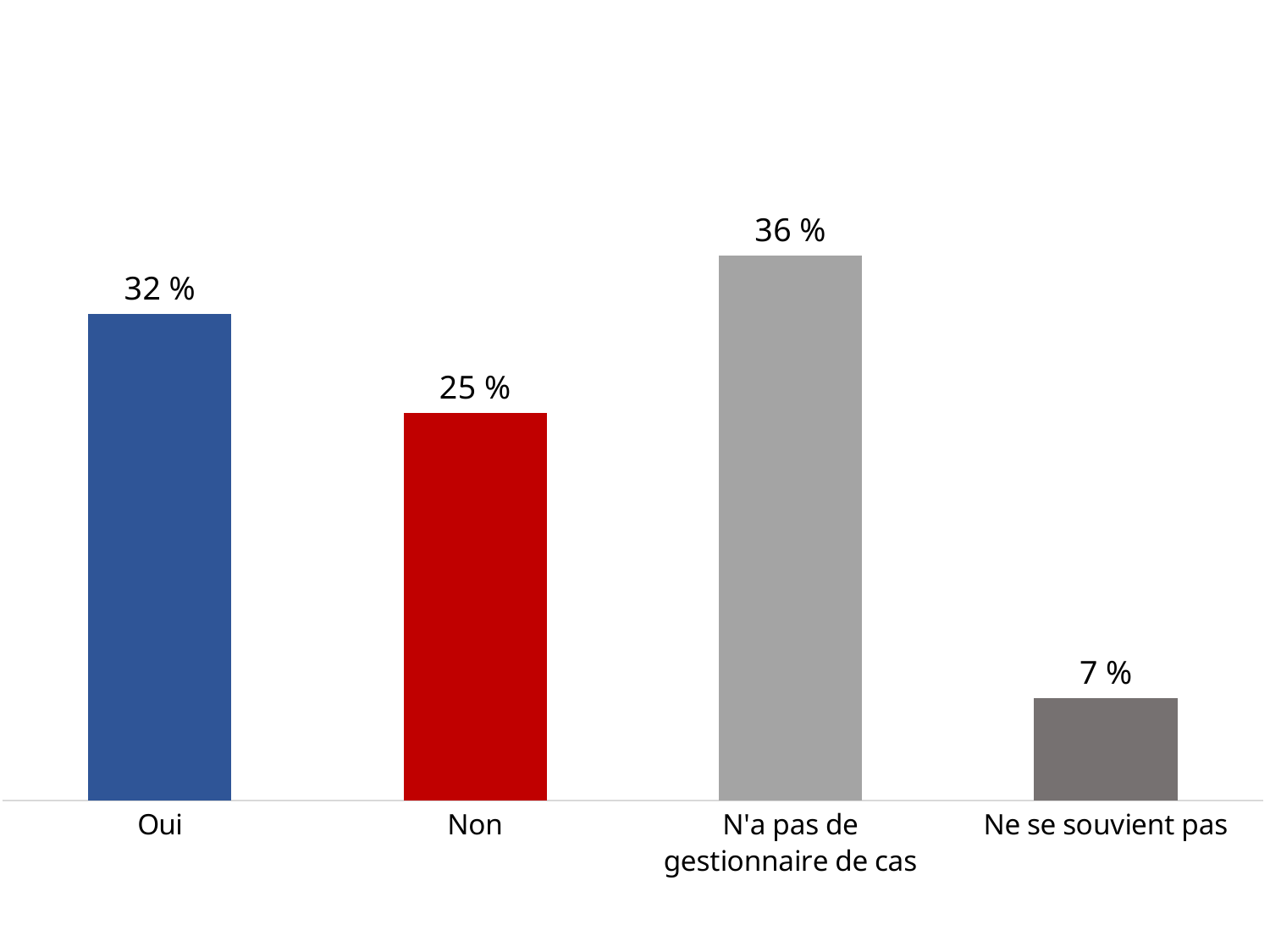
What is the value for N'a pas de gestionnaire de cas? 36 % What is the value for Ne se souvient pas? 7 % What is the difference between the values for N'a pas de gestionnaire de cas and Ne se souvient pas? 29 % Which category has the highest value? N'a pas de gestionnaire de cas What is the difference between the values for Oui and Non? 7 % How many categories are shown in the chart? 4 What colour is the bar for Non? Red What is the value for Oui? 32 % Which is larger, the value for Oui or the value for Non? Oui Which category has the lowest value? Ne se souvient pas What kind of chart is this? Bar chart What is the value for Non? 25 %